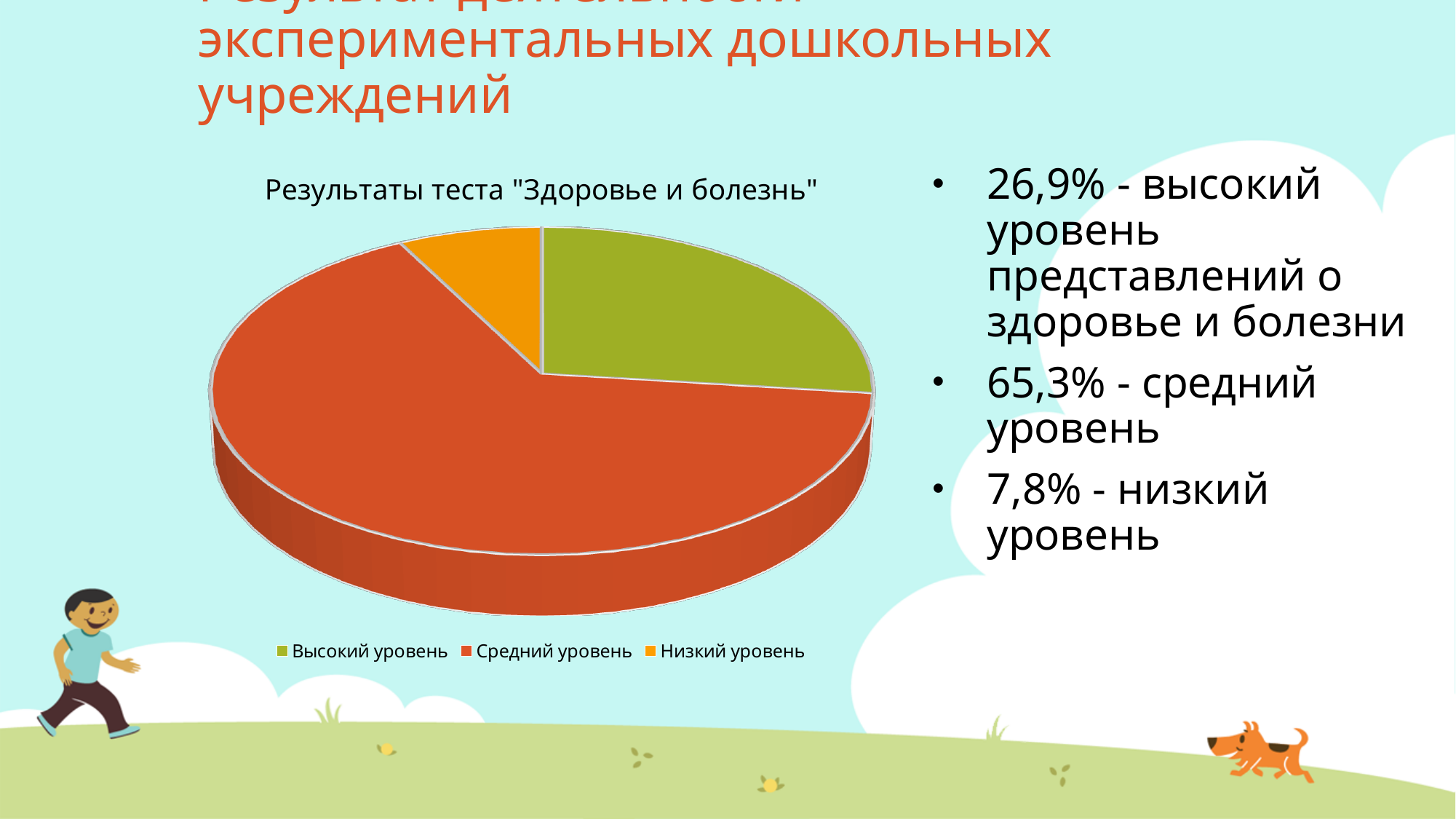
How many entries does the chart legend list? 3 Which category has the largest slice of the pie? Средний уровень What is the difference between the values for Средний уровень and Высокий уровень? 38,4% Which slice is larger, Высокий уровень or Низкий уровень? Высокий уровень What kind of chart is shown on the slide? Pie chart What is the title of the chart? Результаты теста "Здоровье и болезнь" What share of the pie does Средний уровень represent, according to the slide? 65,3% What value does the slide give for Низкий уровень? 7,8% What colour is the slice for Низкий уровень? Orange What value does the slide give for Высокий уровень? 26,9% How many slices does the pie chart have? 3 Which category has the smallest slice of the pie? Низкий уровень